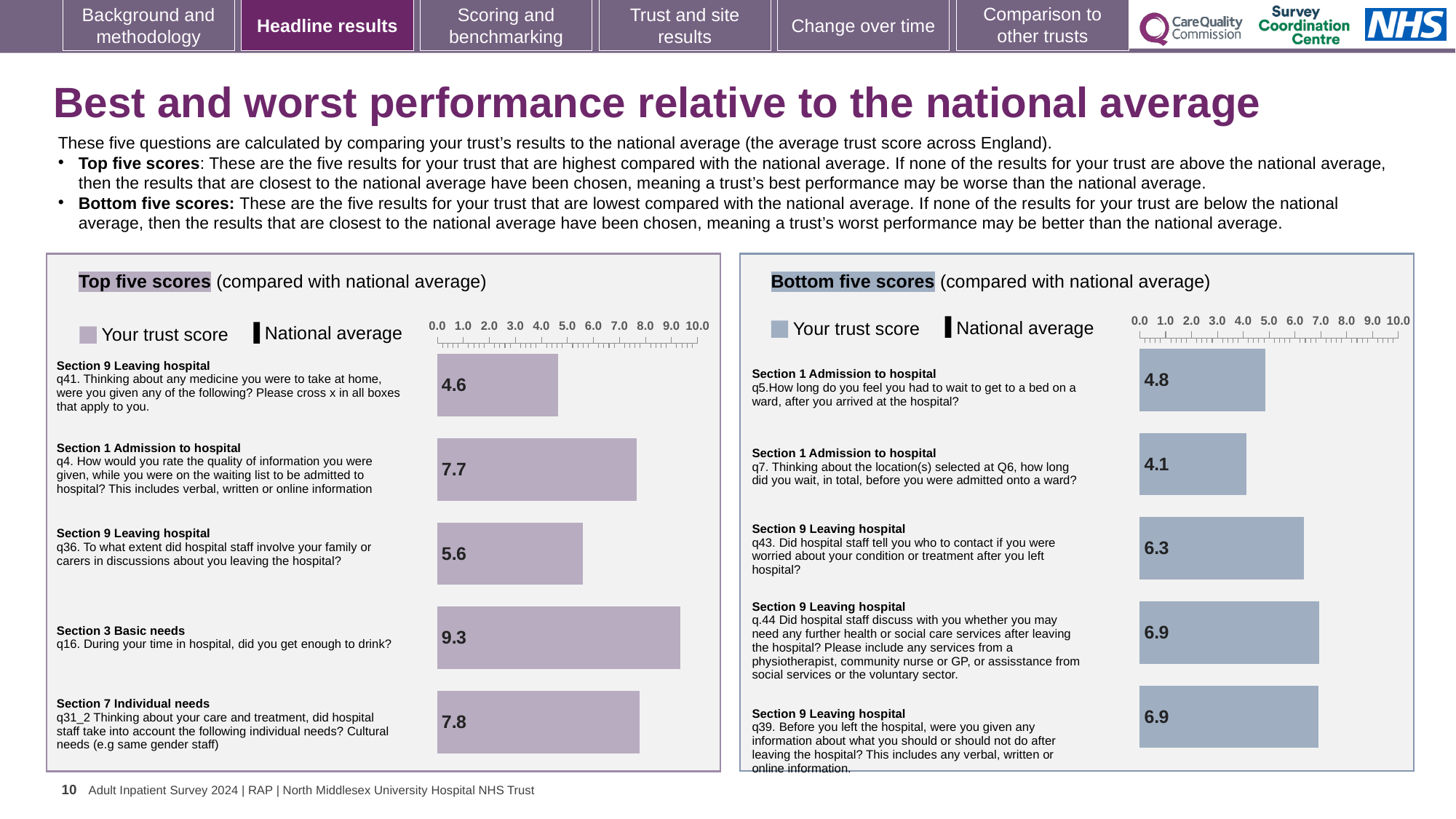
In the Top five scores chart, what is the trust score for q41 about medicine to take at home? 4.6 In the Bottom five scores chart, what is the trust score for q43 about being told who to contact if worried after leaving hospital? 6.3 In the Bottom five scores chart, what is the difference between the trust scores for q44 and q5? 2.1 In the Top five scores chart, what is the difference between the trust scores for q16 and q41? 4.7 In the Bottom five scores chart, which question has the lowest trust score? q7. Thinking about the location(s) selected at Q6, how long did you wait, in total, before you were admitted onto a ward? In the Top five scores chart, which has the larger trust score: q4 or q31_2? q31_2 What type of chart is used for the Top five scores? Bar chart In the Top five scores chart, which question has the highest trust score? q16. During your time in hospital, did you get enough to drink? How many bars are plotted in the Bottom five scores chart? 5 In the Top five scores chart, what is the trust score for q16 (During your time in hospital, did you get enough to drink?)? 9.3 How many series does the legend of the Bottom five scores chart list? 2 In the Bottom five scores chart, what is the trust score for q7 about how long you waited before being admitted onto a ward? 4.1